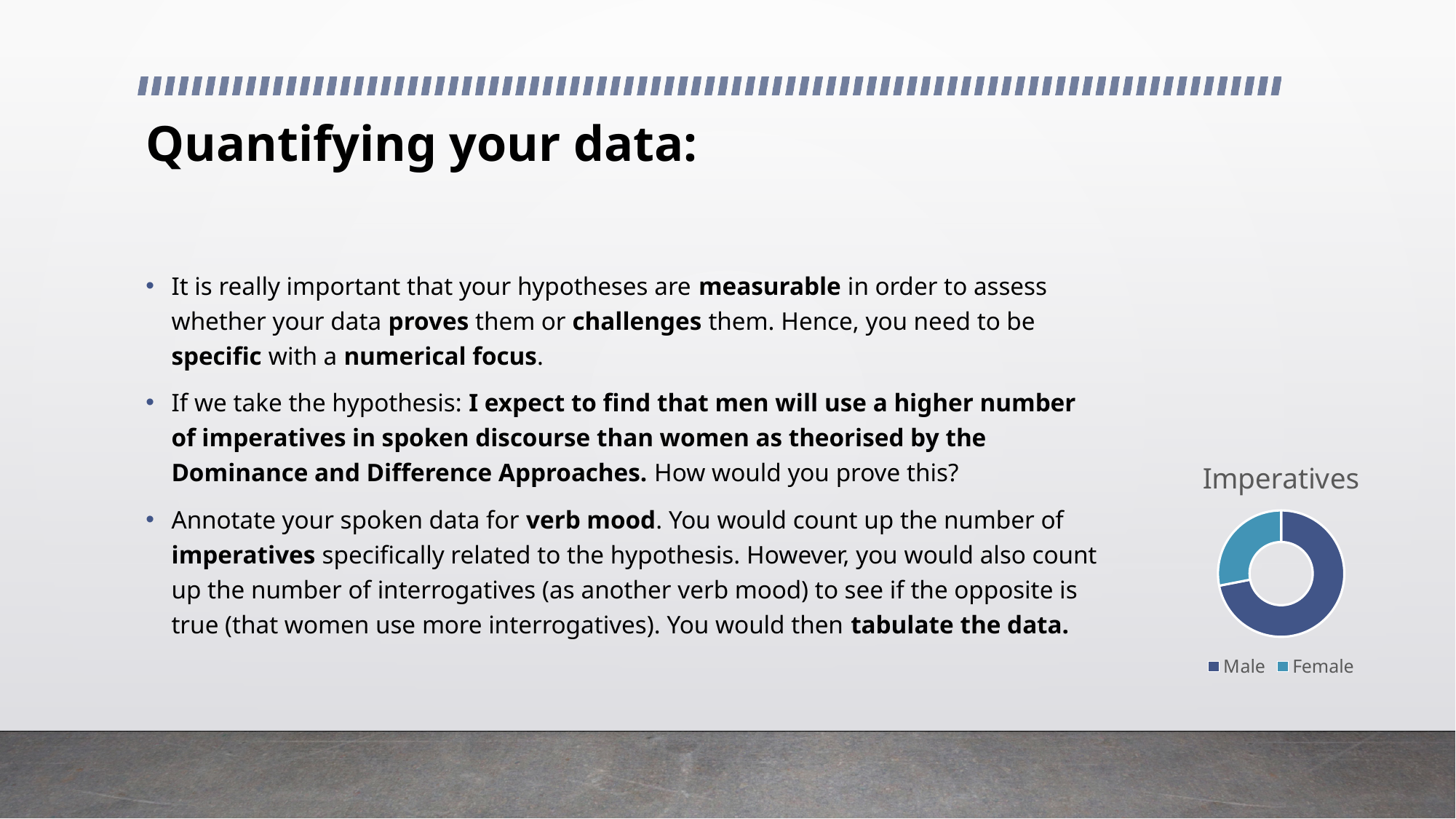
What are the two categories shown in the chart's legend? Male and Female Which category has the smaller share of the Imperatives chart? Female Which category has the larger share of the Imperatives chart? Male What is the title of the chart? Imperatives What kind of chart is shown on the slide? Doughnut chart How many categories does the chart's legend list? 2 Is the Male slice larger or smaller than the Female slice? Larger How many slices does the doughnut chart have? 2